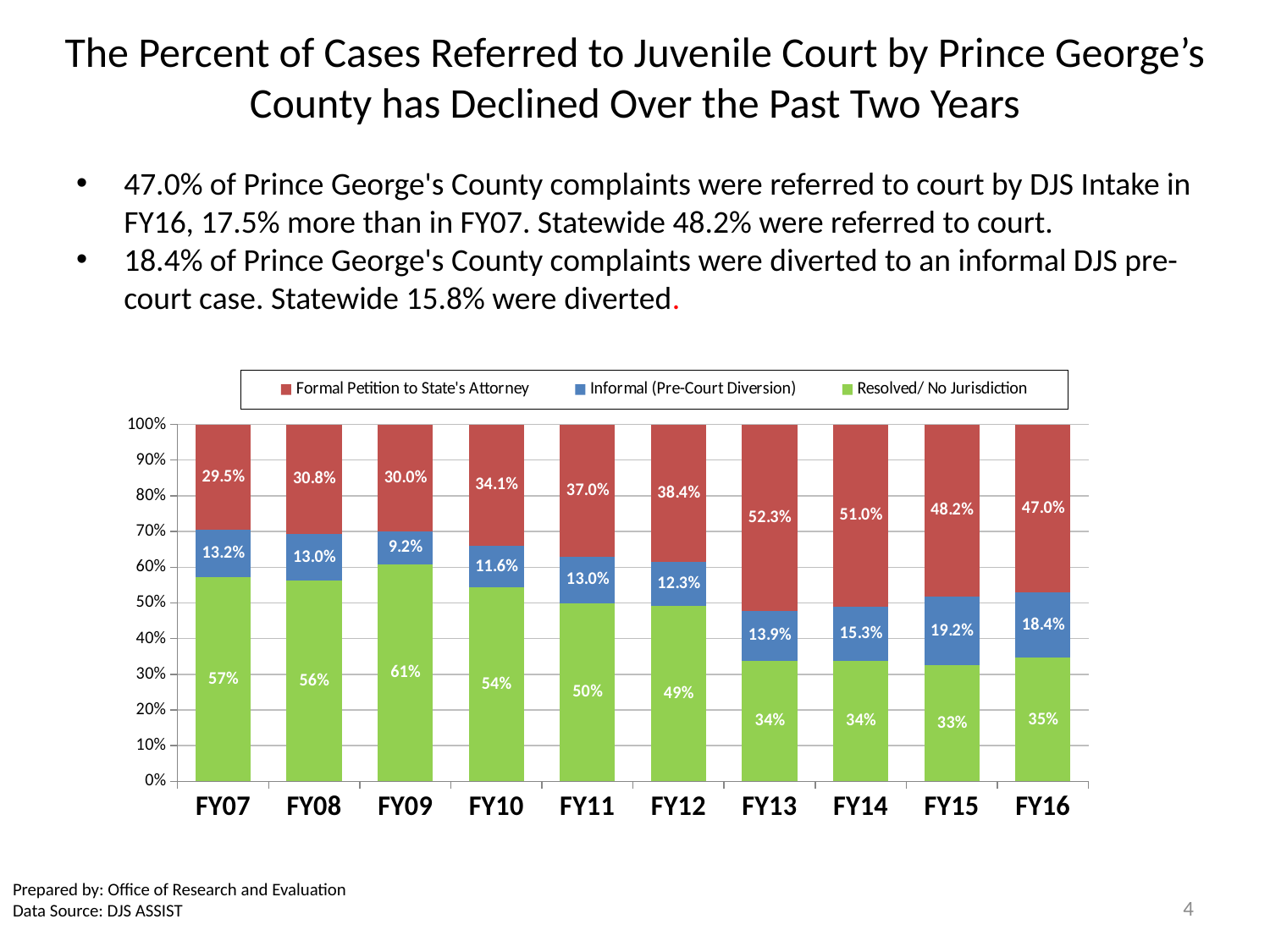
What is the Informal (Pre-Court Diversion) value for FY09? 9.2% In which fiscal year is the Informal (Pre-Court Diversion) share lowest? FY09 How many percentage points higher is the Formal Petition to State's Attorney share in FY16 than in FY07? 17.5 Which is larger: the Informal (Pre-Court Diversion) share in FY15 or in FY14? FY15 In which fiscal year is the Resolved/ No Jurisdiction share highest? FY09 Does the Resolved/ No Jurisdiction share generally rise or fall from FY07 to FY16? Fall What kind of chart is shown on the slide? Stacked bar chart How many fiscal years are shown on the x axis? 10 How many series does the legend list? 3 In which fiscal year is the Formal Petition to State's Attorney share highest? FY13 What is the Resolved/ No Jurisdiction value for FY10? 54% What percentage of cases in FY16 were a Formal Petition to State's Attorney? 47.0%